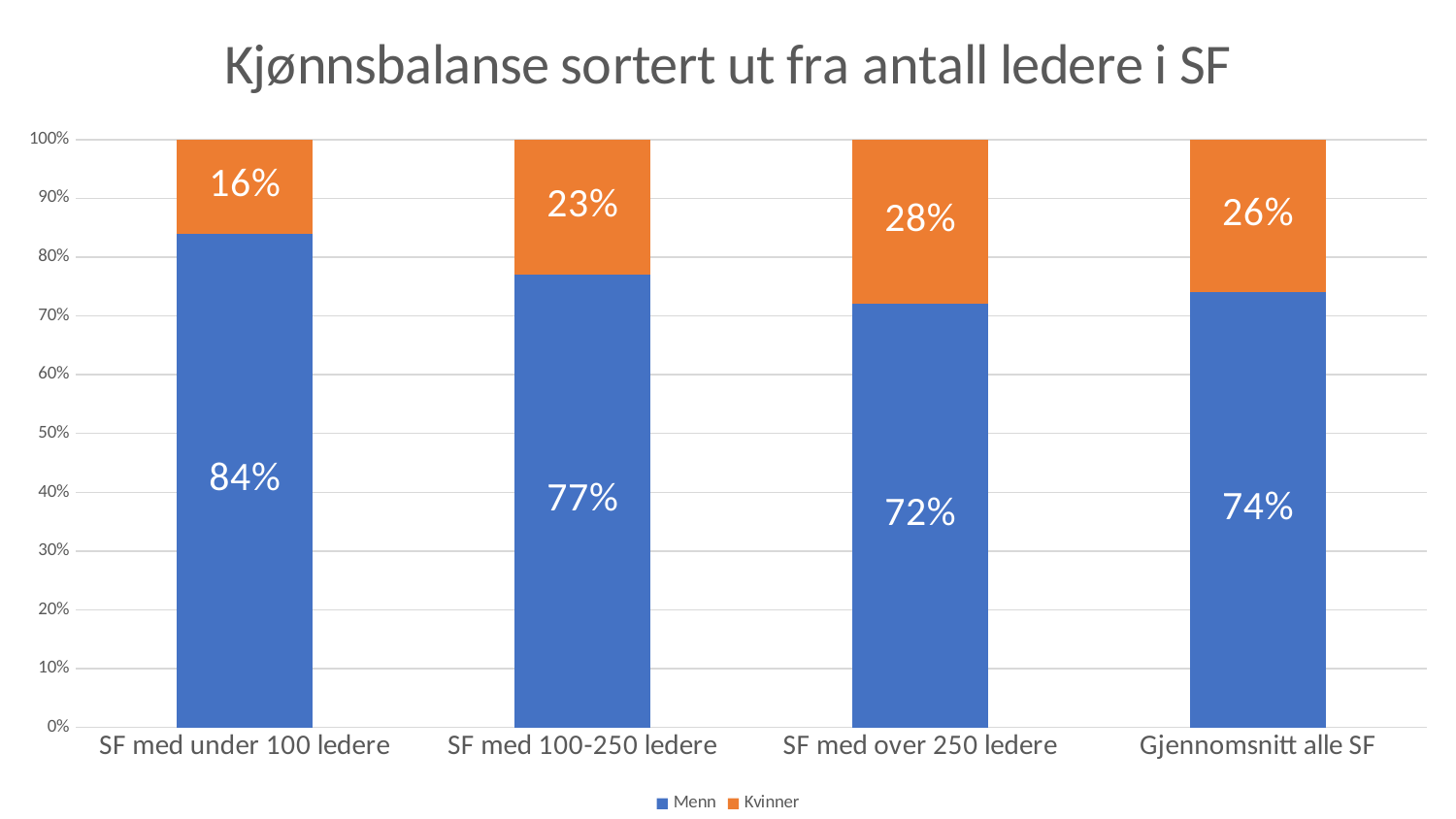
What is the difference between the Menn values for 'SF med under 100 ledere' and 'SF med over 250 ledere'? 12% Which category has the lowest value for Menn? SF med over 250 ledere How many categories are shown on the x axis? 4 What kind of chart is shown on the slide? Stacked bar chart What is the value for Menn in the 'SF med under 100 ledere' category? 84% What is the value for Kvinner in the 'Gjennomsnitt alle SF' category? 26% What is the value for Menn in the 'SF med 100-250 ledere' category? 77% What is the title of the chart? Kjønnsbalanse sortert ut fra antall ledere i SF Which category has the highest value for Kvinner? SF med over 250 ledere Which is larger: the Kvinner value for 'SF med 100-250 ledere' or for 'Gjennomsnitt alle SF'? Gjennomsnitt alle SF What is the value for Kvinner in the 'SF med over 250 ledere' category? 28% How many series does the legend list? 2